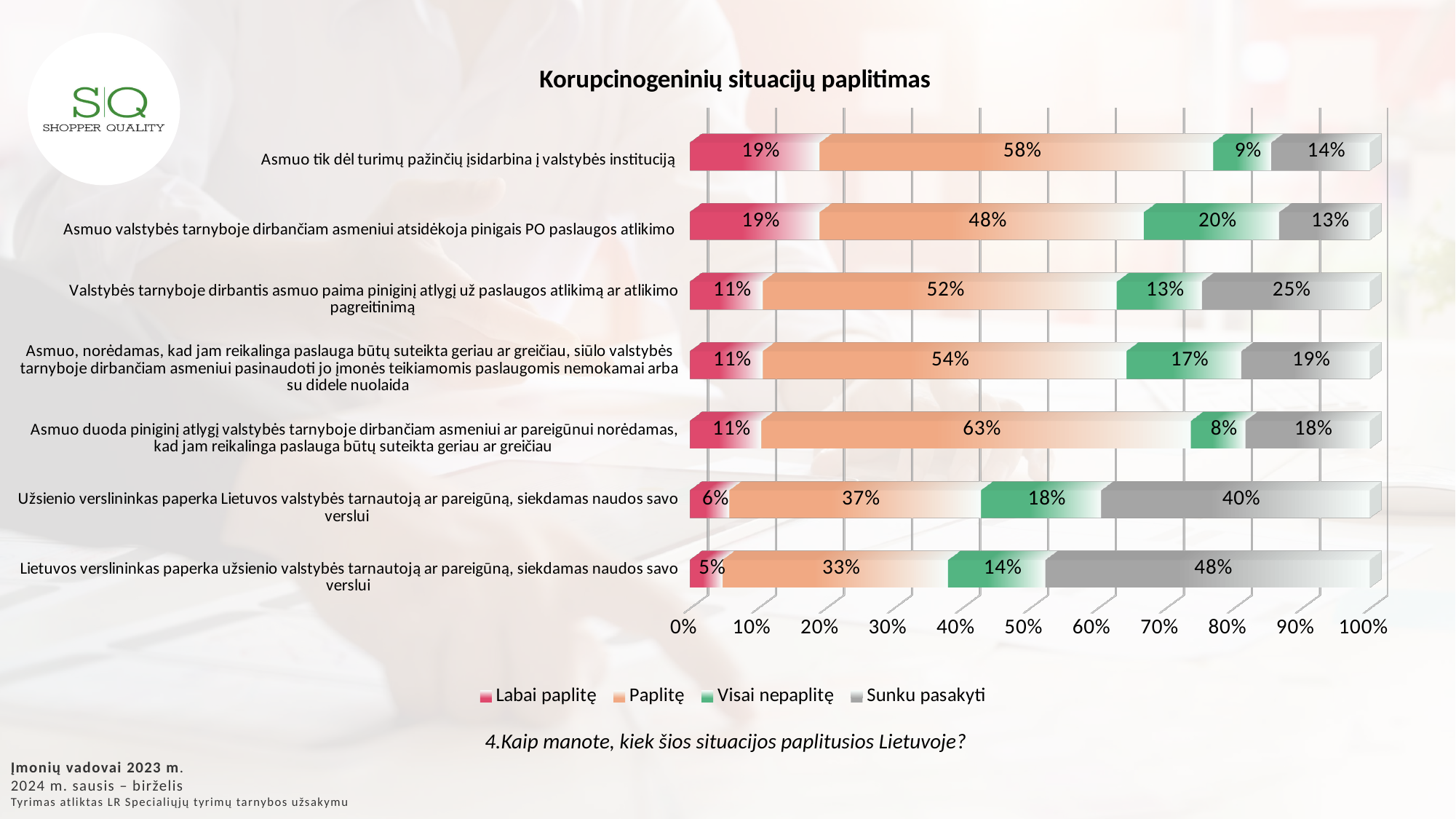
What is the title of the chart? Korupcinogeninių situacijų paplitimas Which category has the highest 'Paplitę' value? Asmuo duoda piniginį atlygį valstybės tarnyboje dirbančiam asmeniui ar pareigūnui norėdamas, kad jam reikalinga paslauga būtų suteikta geriau ar greičiau How many series does the legend list? 4 What type of chart is shown on the slide? Stacked bar chart What is the combined 'Labai paplitę' and 'Paplitę' share for 'Valstybės tarnyboje dirbantis asmuo paima piniginį atlygį už paslaugos atlikimą ar atlikimo pagreitinimą'? 63% What is the difference between the 'Sunku pasakyti' values for 'Užsienio verslininkas paperka Lietuvos valstybės tarnautoją ar pareigūną, siekdamas naudos savo verslui' and 'Asmuo tik dėl turimų pažinčių įsidarbina į valstybės instituciją'? 26% What is the 'Paplitę' value for 'Asmuo tik dėl turimų pažinčių įsidarbina į valstybės instituciją'? 58% How many categories (situations) are plotted in the chart? 7 What is the 'Visai nepaplitę' value for 'Asmuo valstybės tarnyboje dirbančiam asmeniui atsidėkoja pinigais PO paslaugos atlikimo'? 20% What is the 'Sunku pasakyti' value for 'Lietuvos verslininkas paperka užsienio valstybės tarnautoją ar pareigūną, siekdamas naudos savo verslui'? 48% Which is larger: the 'Visai nepaplitę' value for 'Asmuo duoda piniginį atlygį valstybės tarnyboje dirbančiam asmeniui ar pareigūnui...' or for 'Užsienio verslininkas paperka Lietuvos valstybės tarnautoją ar pareigūną...'? Užsienio verslininkas paperka Lietuvos valstybės tarnautoją ar pareigūną, siekdamas naudos savo verslui Which category has the lowest 'Labai paplitę' value? Lietuvos verslininkas paperka užsienio valstybės tarnautoją ar pareigūną, siekdamas naudos savo verslui